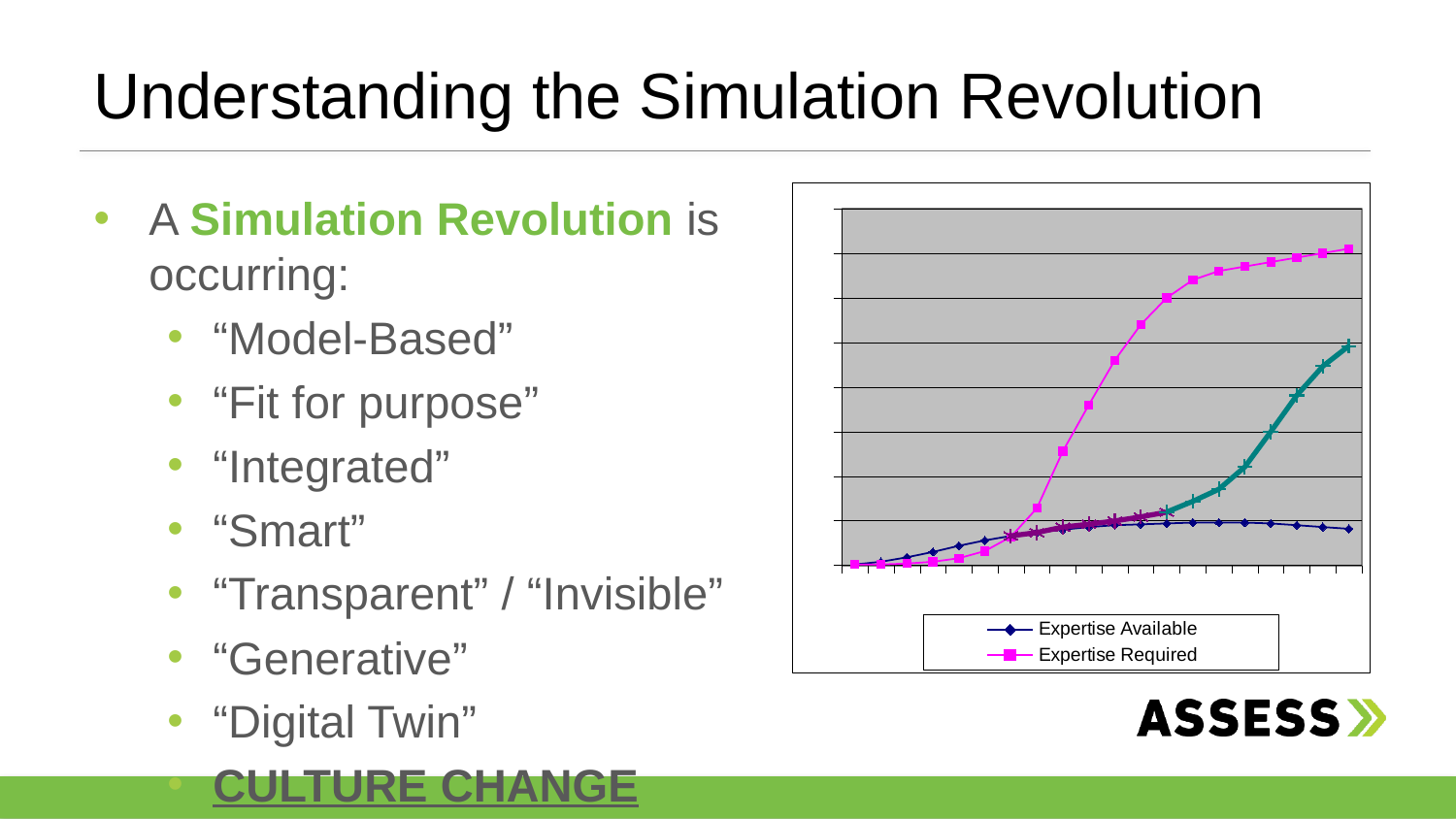
What are the two series named in the chart's legend? Expertise Available and Expertise Required Does the Expertise Available line rise steeply or stay relatively flat across the right half of the chart? stay relatively flat How many series does the chart's legend list? 2 What kind of chart is shown on the slide? line chart Does the Expertise Required line rise or fall from left to right along the x axis? rise At the right-hand end of the chart, which series is higher: Expertise Available or Expertise Required? Expertise Required Which legend series reaches the highest point on the chart? Expertise Required What colour is the Expertise Required line in the chart? magenta (pink) Which legend series is lowest at the right-hand end of the chart? Expertise Available